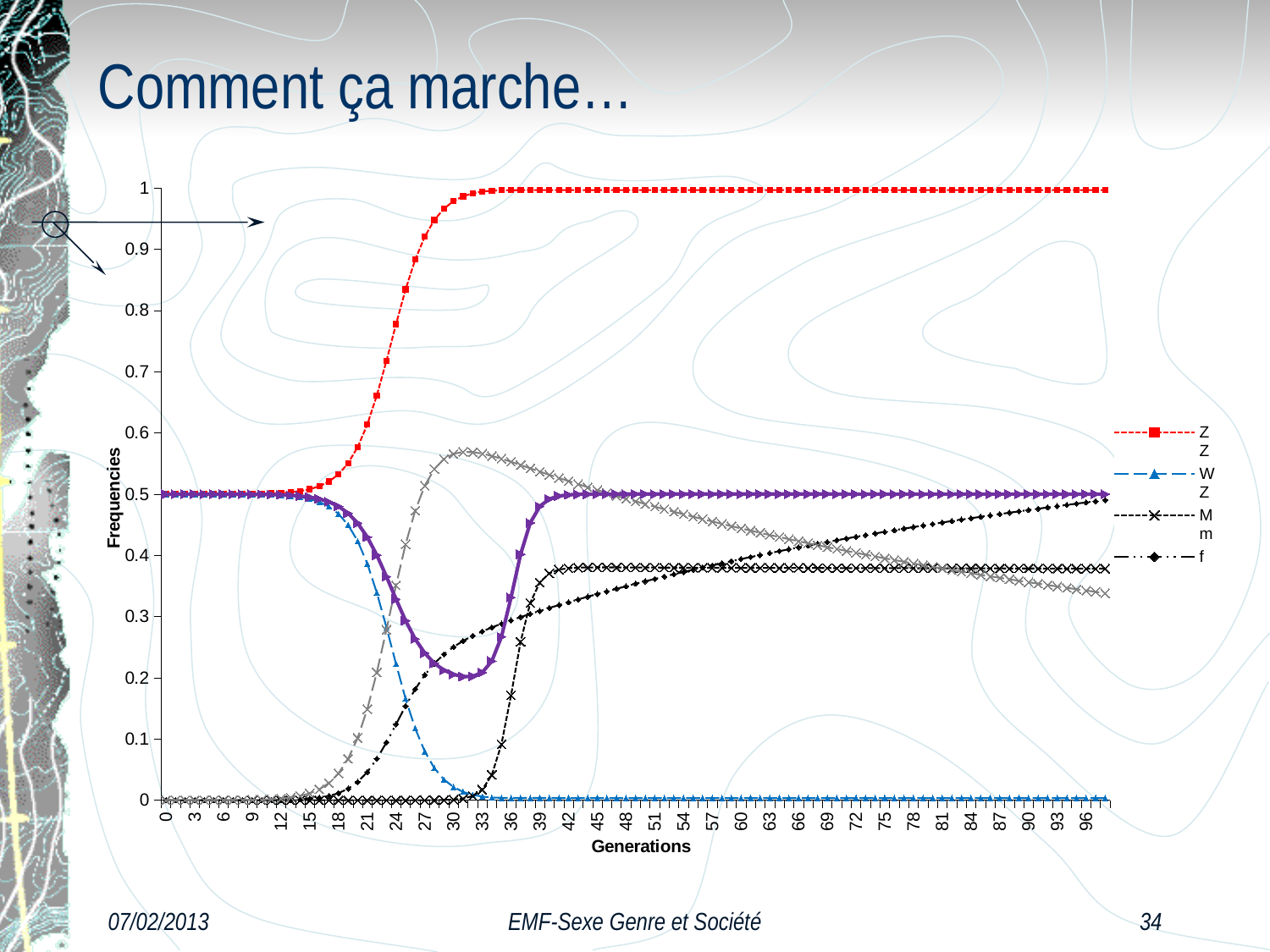
At generation 90, which is larger: the Z Z series or the W Z series? Z Z Is the value of the Z Z series at generation 60 greater or less than 0.9? greater What is the title of the x axis? Generations Is the value of the W Z series at generation 60 greater or less than 0.1? less Does the W Z series rise or fall as generations increase? fall Does the Z Z series rise or fall as generations increase? rise Is the value of the f series at generation 90 greater or less than 0.4? greater What is the title of the y axis? Frequencies Which legend series has the lowest value at generation 90? W Z What kind of chart is shown on the slide? line chart How many series does the legend list? 4